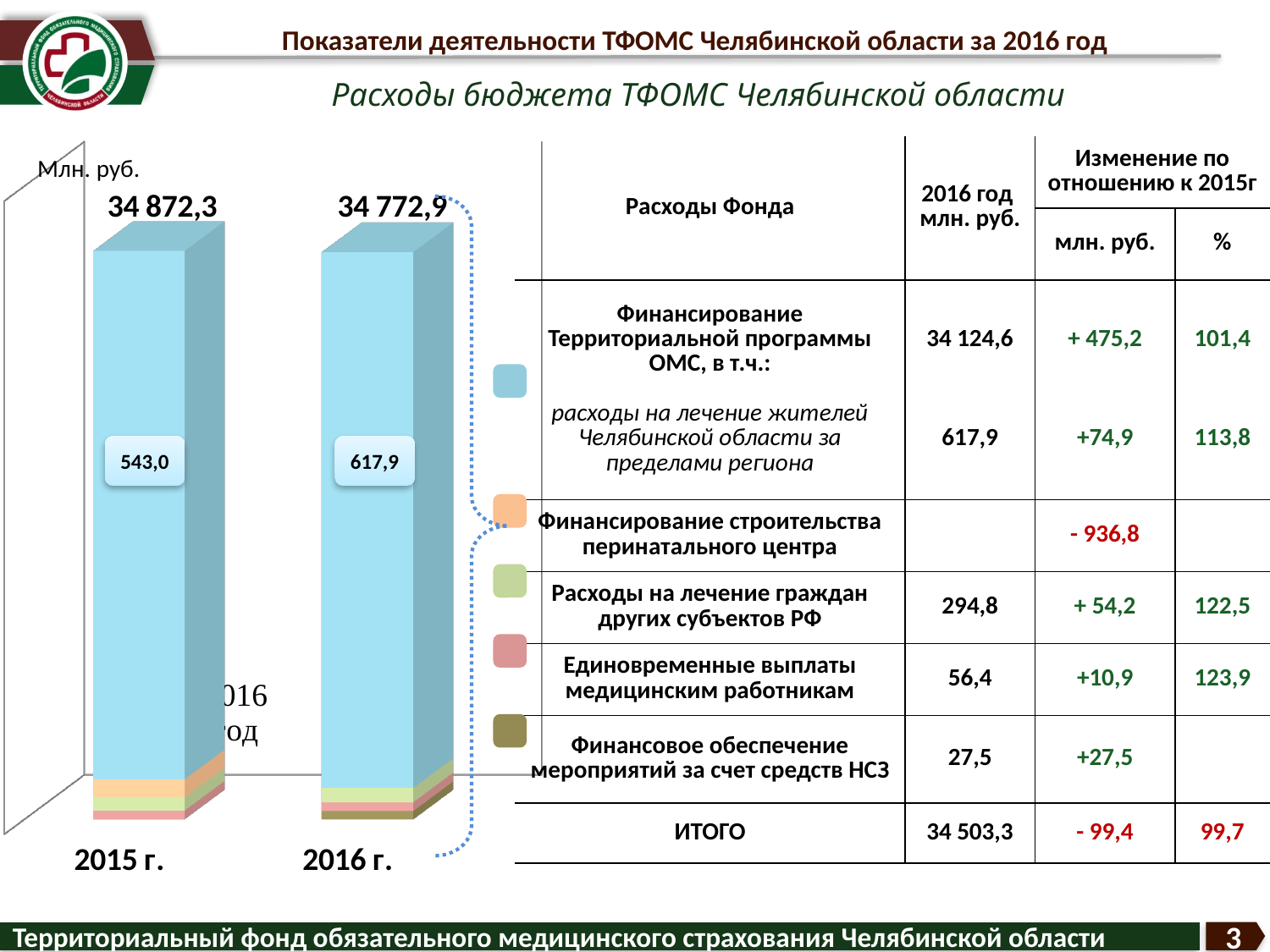
What value is printed inside the large light-blue segment of the 2015 г. bar? 543,0 Which year has the higher total value on the bar chart? 2015 г. What value is printed inside the large light-blue segment of the 2016 г. bar? 617,9 What is the difference between the total for 2015 г. (34 872,3) and the total for 2016 г. (34 772,9)? 99,4 What is the total value shown above the bar for 2015 г.? 34 872,3 What unit is indicated at the top left of the chart? Млн. руб. Does the total value rise or fall from 2015 г. to 2016 г.? Fall What is the difference between the inner label of the 2016 г. bar (617,9) and the inner label of the 2015 г. bar (543,0)? 74,9 How many bars are shown on the chart? 2 What kind of chart is shown on the left of the slide? Bar chart Which bar has the larger inner label value, 2015 г. or 2016 г.? 2016 г. What is the total value shown above the bar for 2016 г.? 34 772,9